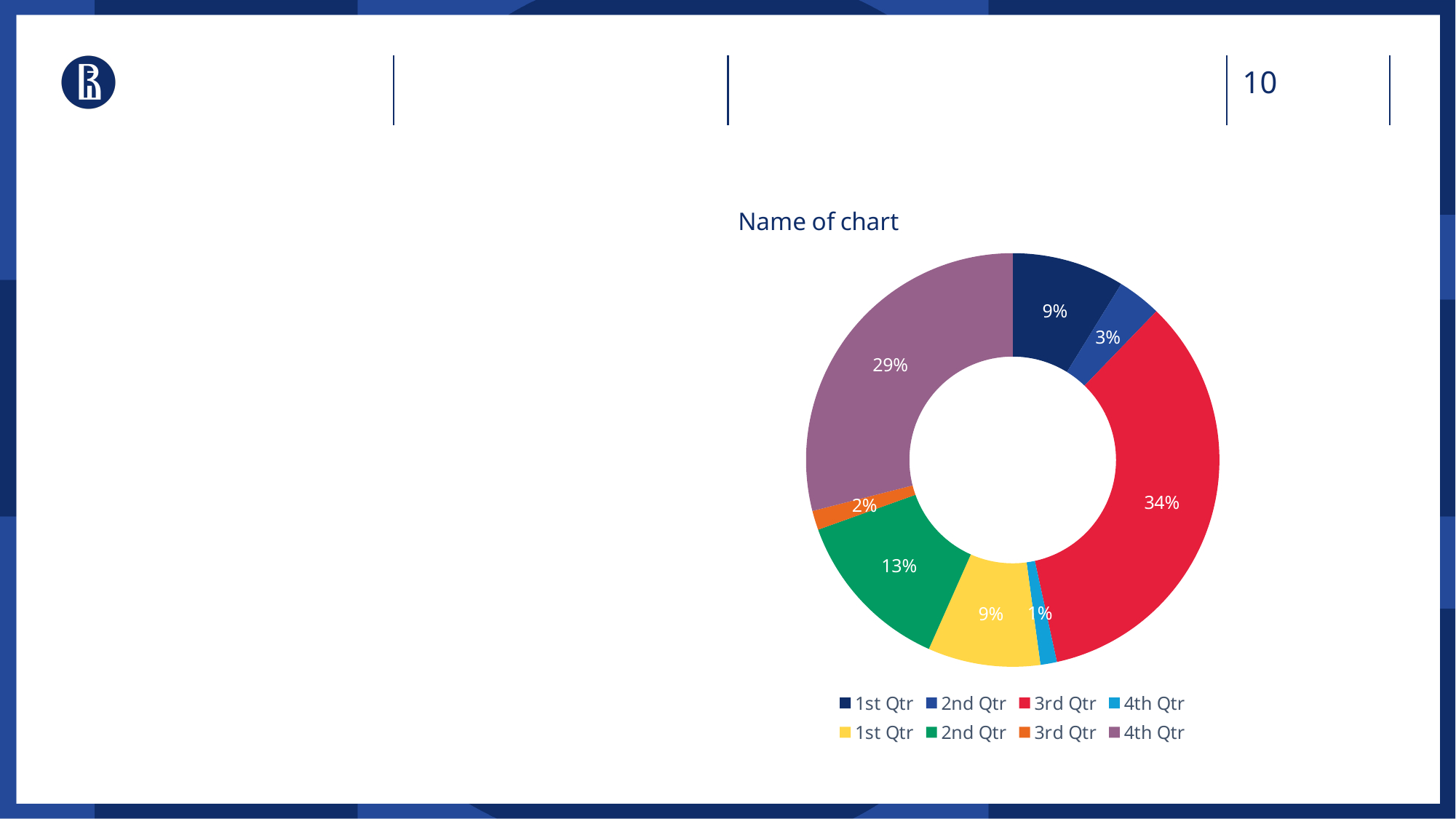
How many entries does the chart legend list? 8 What is the title of the chart? Name of chart What is the smallest percentage shown on the chart? 1% What percentage is shown on the red slice (3rd Qtr)? 34% What percentage is shown on the green slice (2nd Qtr)? 13% How many slices does the doughnut chart have? 8 What type of chart is shown on the slide? doughnut chart What is the largest percentage shown on the chart? 34% What percentage is shown on the purple slice (4th Qtr)? 29% What is the difference between the red slice (34%) and the purple slice (29%)? 5% Which slice is larger, the green slice or the yellow slice? the green slice What percentage is shown on the orange slice (3rd Qtr)? 2%